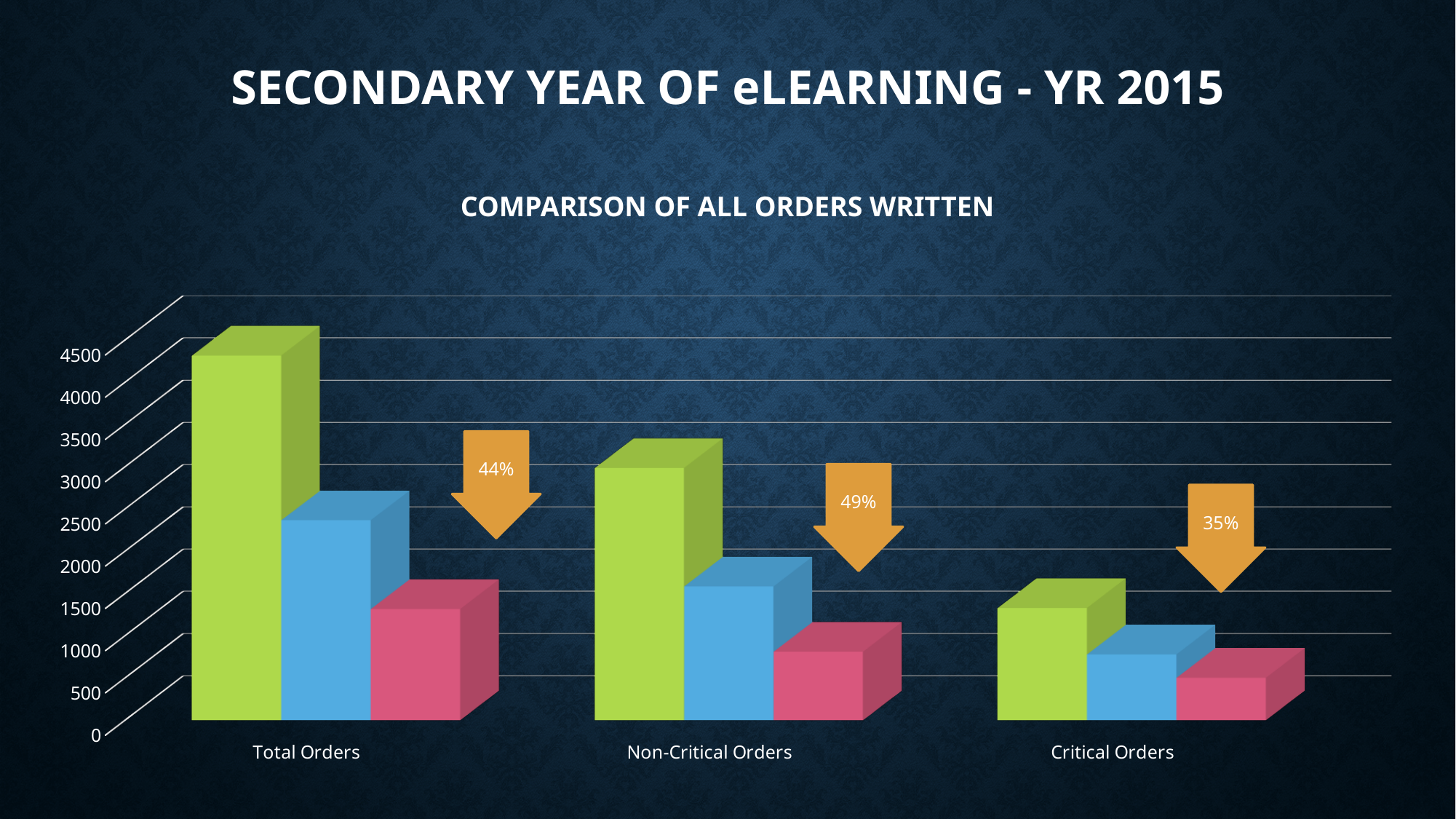
How many bars are plotted for each category in the chart? 3 Which category has the shortest green bar? Critical Orders Which category has the tallest green bar? Total Orders Is the value of the blue bar for Non-Critical Orders greater or less than 2500? less How many categories are shown on the x axis of the chart? 3 What percentage is shown in the orange arrow next to the Non-Critical Orders bars? 49% Do the green bars rise or fall from Total Orders to Critical Orders along the x axis? fall What is the title of the chart? COMPARISON OF ALL ORDERS WRITTEN For Non-Critical Orders, which is larger, the green bar or the blue bar? green bar Is the value of the green bar for Total Orders greater or less than 4000? greater Is the value of the green bar for Critical Orders greater or less than 2000? less What kind of chart is shown on the slide? bar chart